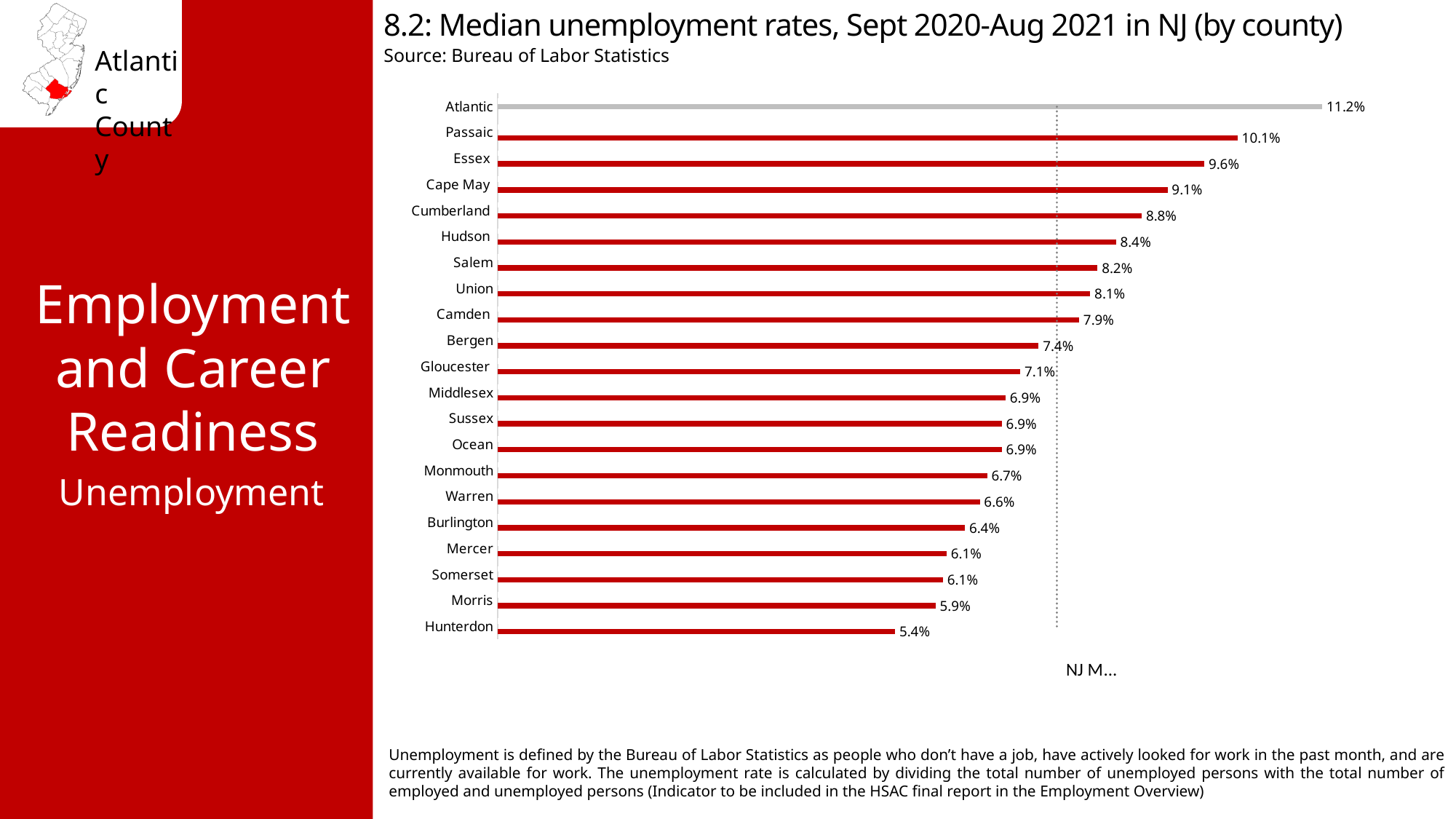
Which has a higher median unemployment rate, Morris or Burlington? Burlington What is the median unemployment rate for Cape May? 9.1% What is the difference between the median unemployment rates of Essex and Hunterdon? 4.2% What kind of chart is used to show the median unemployment rates? Bar chart How many counties are shown in the chart? 21 What is the median unemployment rate for Hunterdon? 5.4% Which county has the lowest median unemployment rate? Hunterdon Which county's bar is coloured grey instead of red? Atlantic Which county has the highest median unemployment rate? Atlantic What is the median unemployment rate for Atlantic County? 11.2% What is the difference between the median unemployment rates of Atlantic and Passaic? 1.1% Which has a higher median unemployment rate, Hudson or Camden? Hudson